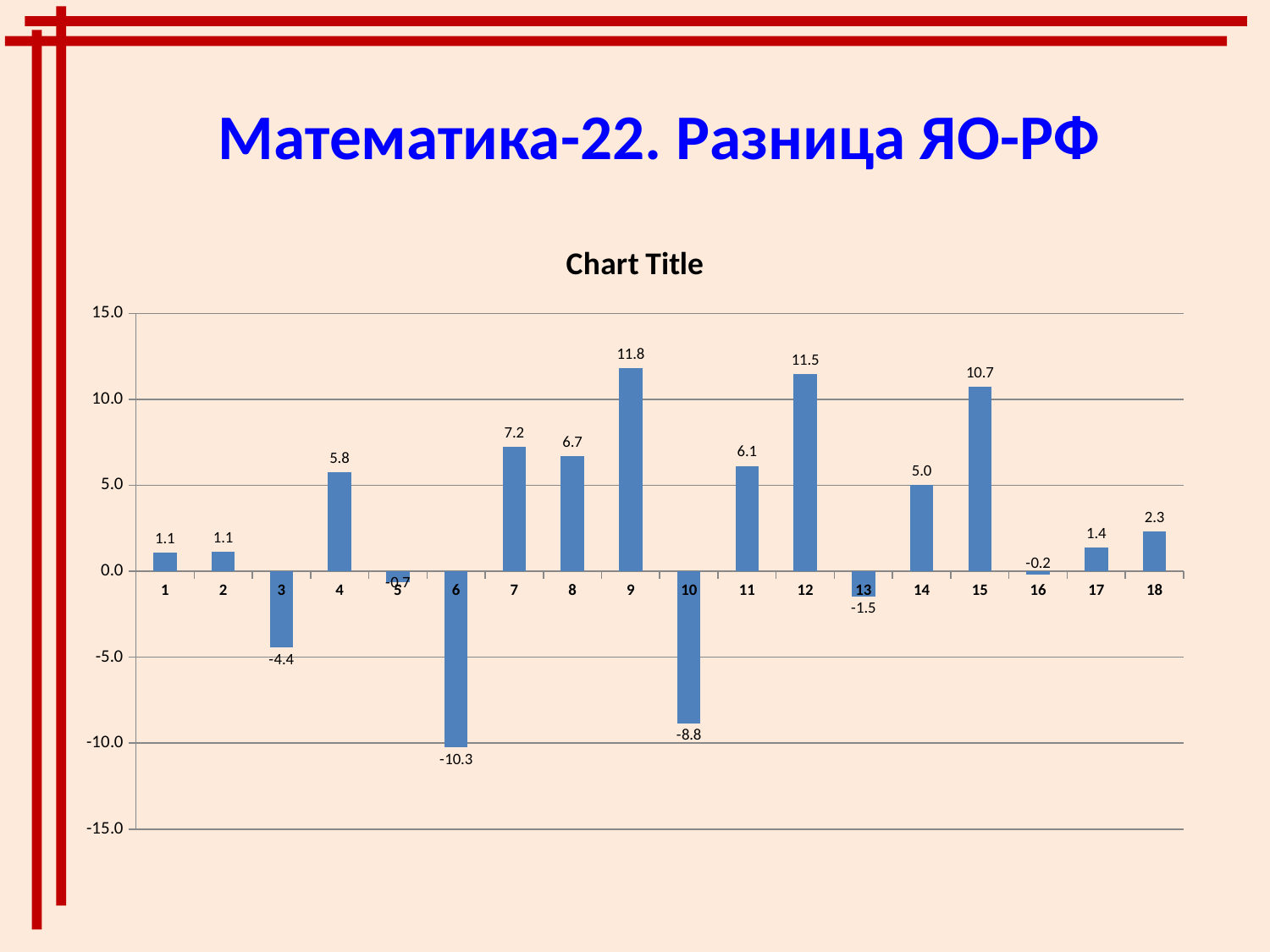
Which category has the lowest value? 6 What kind of chart is shown on the slide? bar chart How many categories are shown on the x axis? 18 What is the value for category 9? 11.8 Is the value for category 10 greater or less than -5.0? less Which is larger, the value for category 4 or the value for category 8? category 8 What is the title of the slide? Математика-22. Разница ЯО-РФ What is the value for category 15? 10.7 What is the value for category 13? -1.5 What is the difference between the values for category 9 and category 12? 0.3 What is the value for category 6? -10.3 Which category has the highest value? 9